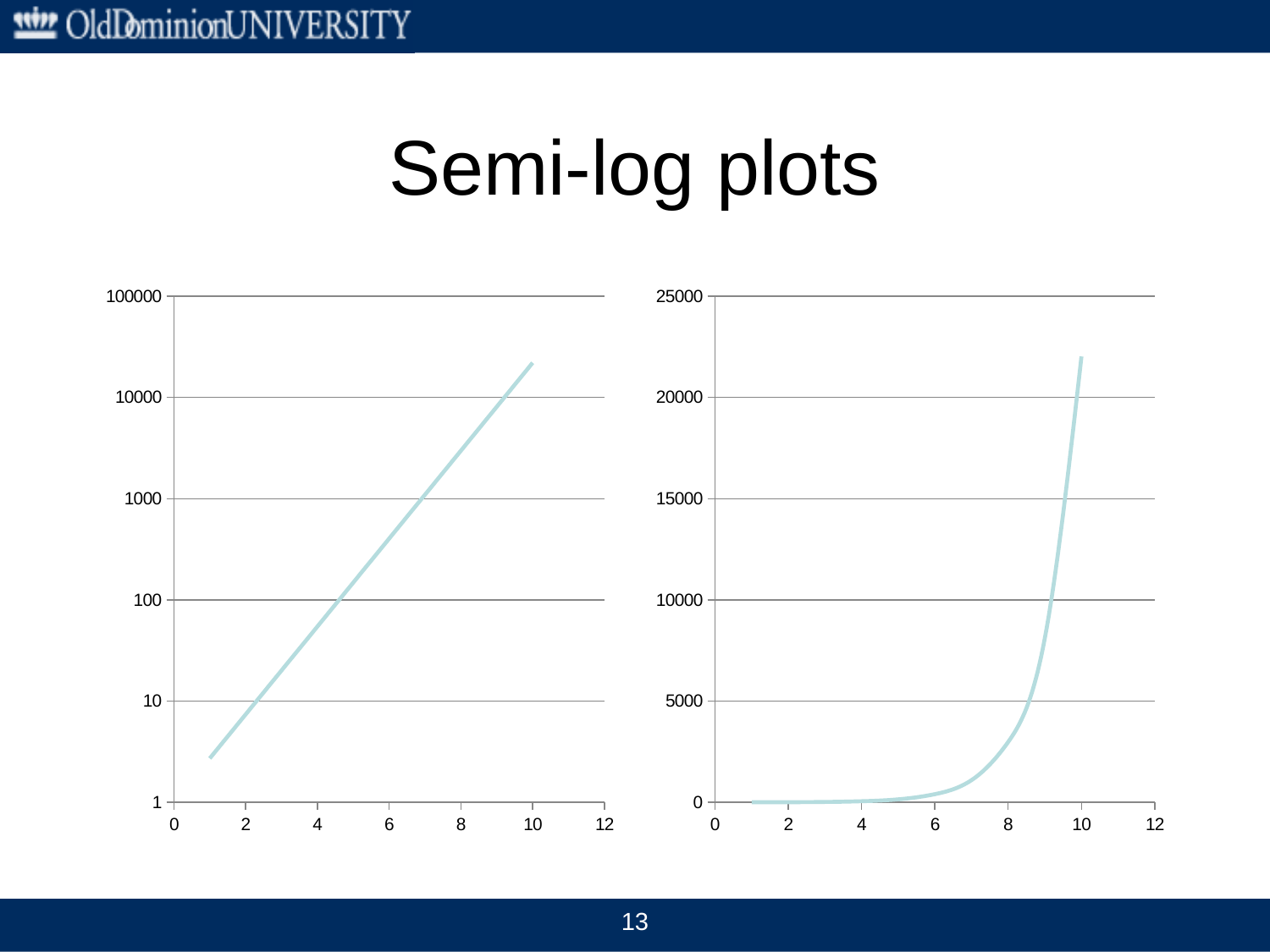
In the left chart, do the values rise or fall as x increases? rise What is the highest tick label on the y axis of the right chart? 25000 In the right chart, is the value at x = 10 greater or less than 20000? greater What kind of chart is the left chart on the slide? line chart In the right chart, do the values rise or fall as x increases? rise In the right chart, is the value at x = 6 greater or less than 5000? less In the left chart, is the value at x = 10 greater or less than 10000? greater What is the highest tick label on the y axis of the left chart? 100000 What kind of chart is the right chart on the slide? line chart